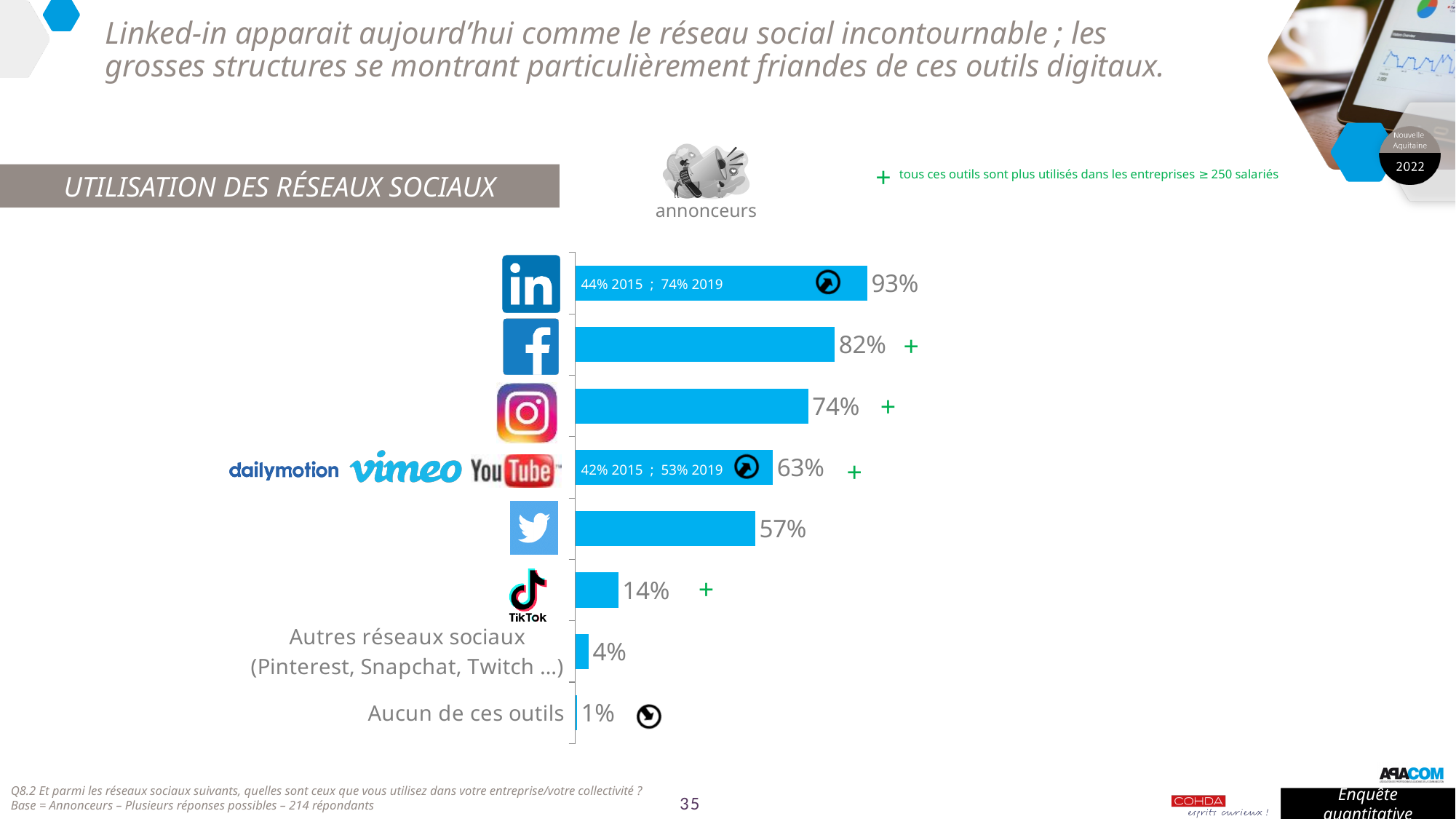
Which is larger: the value for Twitter or the value for the video platforms (Dailymotion/Vimeo/YouTube)? Video platforms (Dailymotion/Vimeo/YouTube) Which social network has the highest usage in the chart? LinkedIn What is the value for 'Autres réseaux sociaux (Pinterest, Snapchat, Twitch …)'? 4% What percentage of advertisers use LinkedIn according to the chart? 93% Which category has the lowest value in the chart? Aucun de ces outils What value is shown for TikTok? 14% What is the value shown for the Facebook bar? 82% What percentage is shown for 'Aucun de ces outils'? 1% What is the difference between the Facebook value and the Instagram value? 8% How many bars (categories) does the chart show? 8 What type of chart is used on the slide? Bar chart What was the LinkedIn usage value in 2019, as printed on the LinkedIn bar? 74%